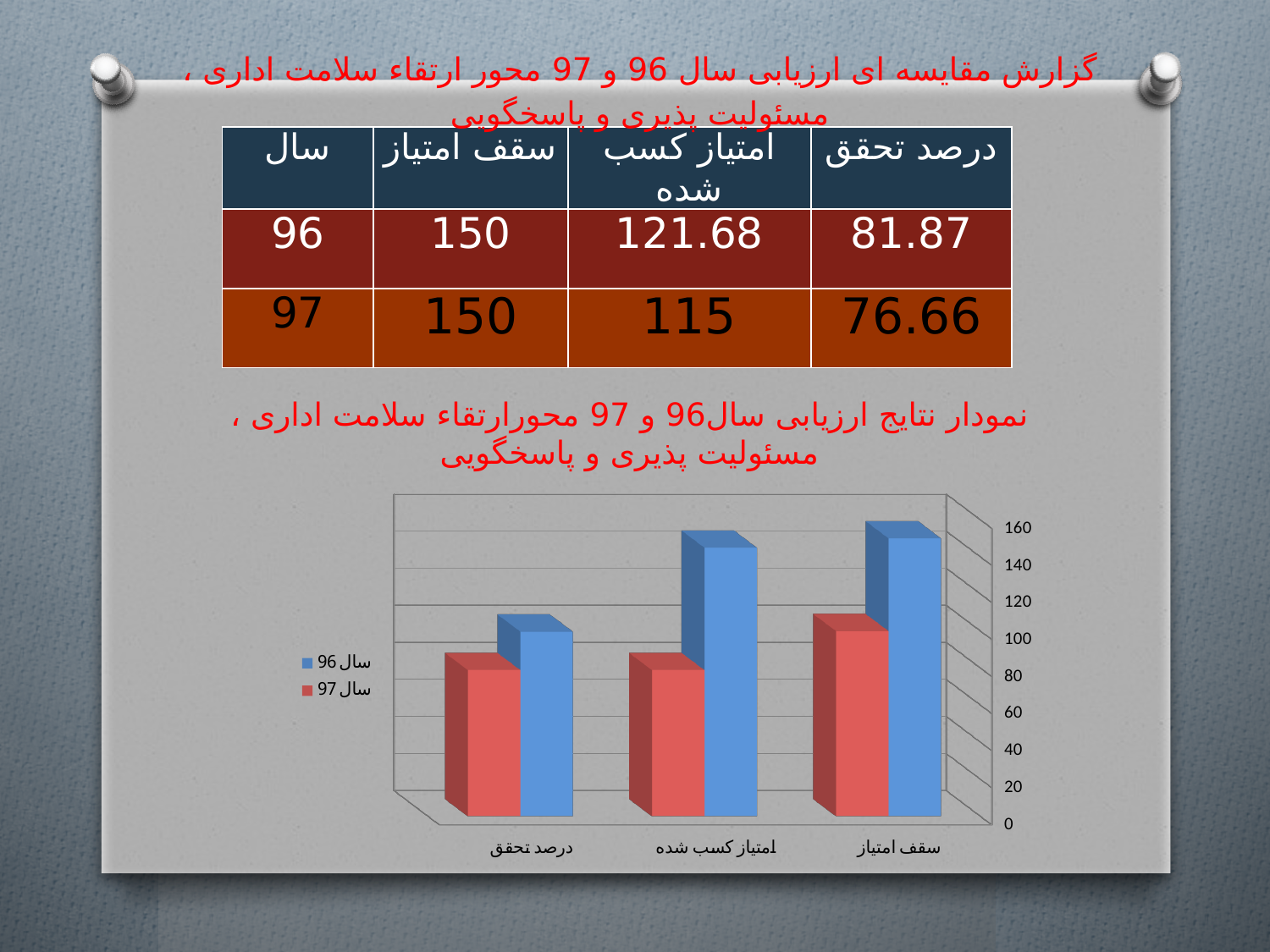
Which category has the tallest bars in the chart? سقف امتیاز Is the value for سال 97 in the درصد تحقق category greater or less than 100? less How many series does the chart legend list? 2 What kind of chart is shown on the slide? bar chart What are the two series named in the chart legend? سال 96 and سال 97 Which category has the shortest bars in the chart? درصد تحقق According to the table on the slide, what is the امتیاز کسب شده value for year 96? 121.68 Is the value for سال 96 in the سقف امتیاز category greater or less than 100? greater In the chart, for امتیاز کسب شده, which series has the larger value, سال 96 or سال 97? سال 96 In the chart, for درصد تحقق, which series has the larger value, سال 96 or سال 97? سال 96 How many categories are shown on the x axis of the chart? 3 According to the table on the slide, what is the difference between the درصد تحقق values for year 96 and year 97? 5.21